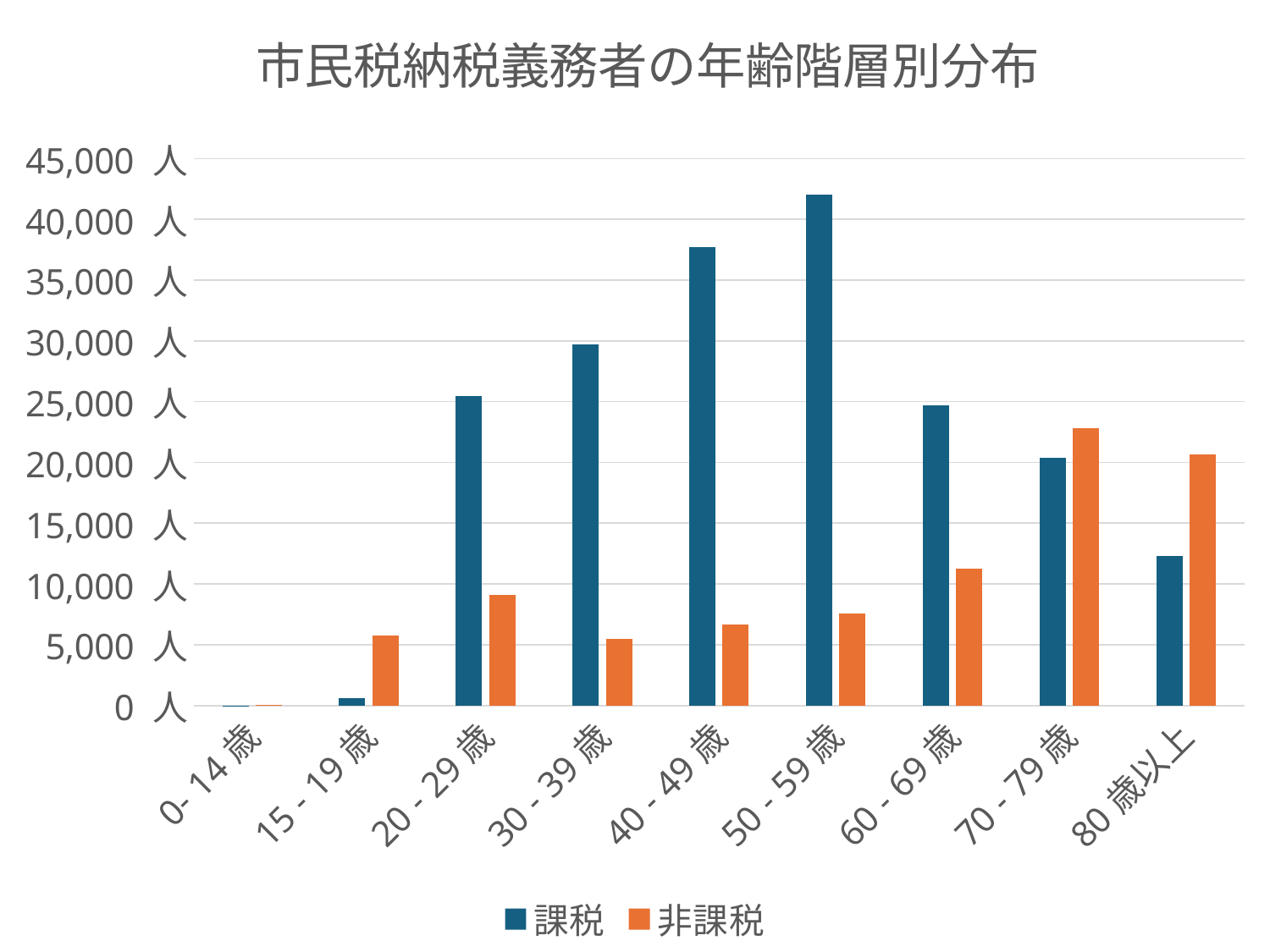
Is the 課税 value for 40 - 49 歳 greater or less than 35,000 人? greater For 80 歳以上, which is larger: 課税 or 非課税? 非課税 What kind of chart is shown on the slide? bar chart Which age category has the highest 非課税 value? 70 - 79 歳 Is the 非課税 value for 60 - 69 歳 greater or less than 10,000 人? greater How many series does the legend list? 2 Which age category has the highest 課税 value? 50 - 59 歳 How many age categories are shown on the x axis? 9 Do the 課税 values rise or fall from 50 - 59 歳 to 80 歳以上? fall For 20 - 29 歳, which is larger: 課税 or 非課税? 課税 Which age category has the lowest 課税 value? 0 - 14 歳 Is the 課税 value for 50 - 59 歳 greater or less than 40,000 人? greater